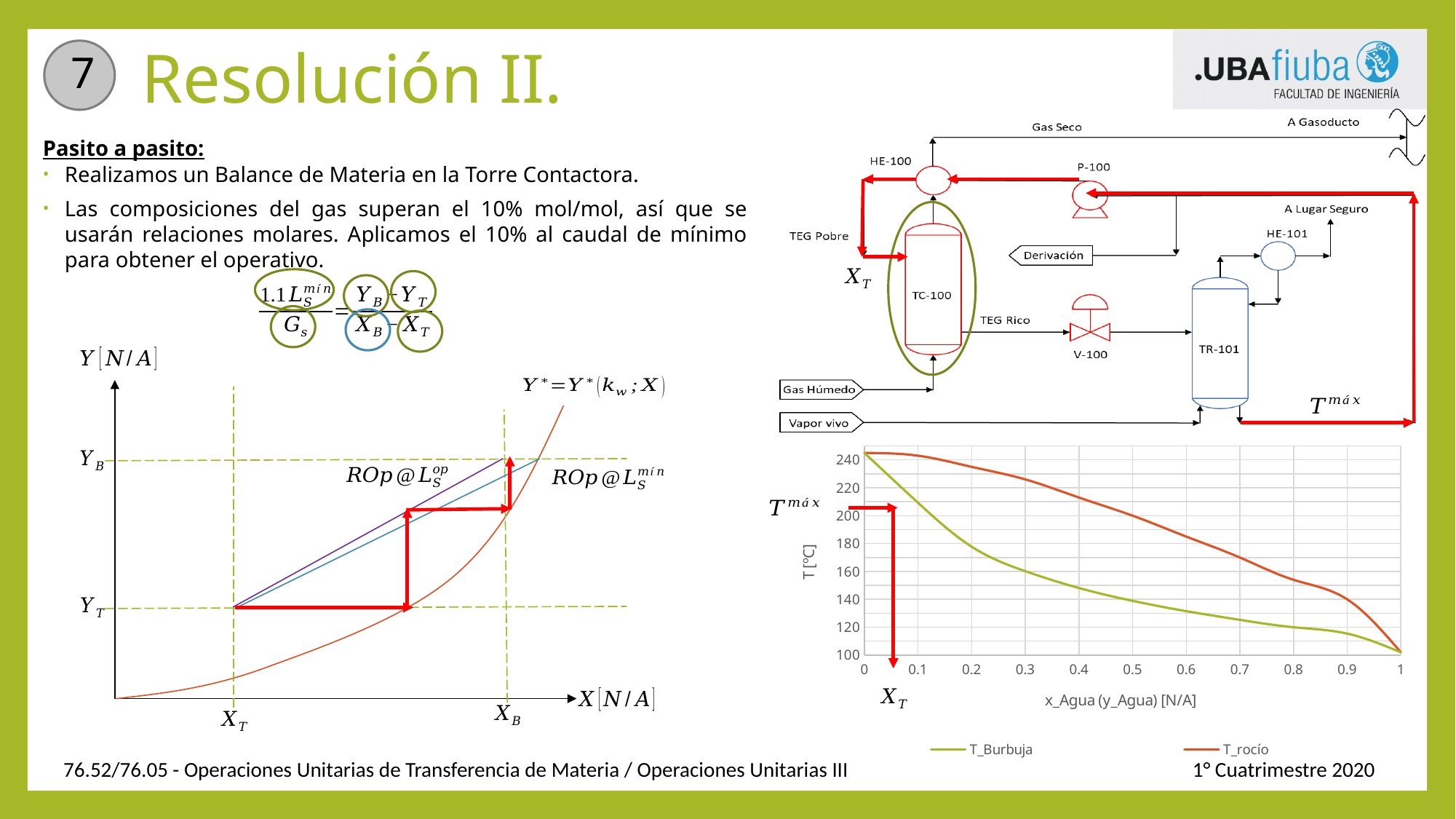
In the bottom-right chart, do the T_rocío values rise or fall as x_Agua increases from 0 to 1? fall What is the label of the y axis of the bottom-right chart? T [°C] How many series does the legend of the bottom-right chart list? 2 In the bottom-right chart, is the T_rocío value at x_Agua = 0.5 greater or less than 180? greater In the bottom-right chart, is the T_Burbuja value at x_Agua = 0.5 greater or less than 160? less In the bottom-right chart, which series has the higher temperature at x_Agua = 0.5, T_Burbuja or T_rocío? T_rocío What are the two series named in the legend of the bottom-right chart? T_Burbuja and T_rocío In the bottom-right chart, is the T_rocío value at x_Agua = 0.7 greater or less than 160? greater What kind of chart is the chart at the bottom right of the slide (T vs x_Agua)? line chart In the bottom-right chart, do the T_Burbuja values rise or fall as x_Agua increases from 0 to 1? fall